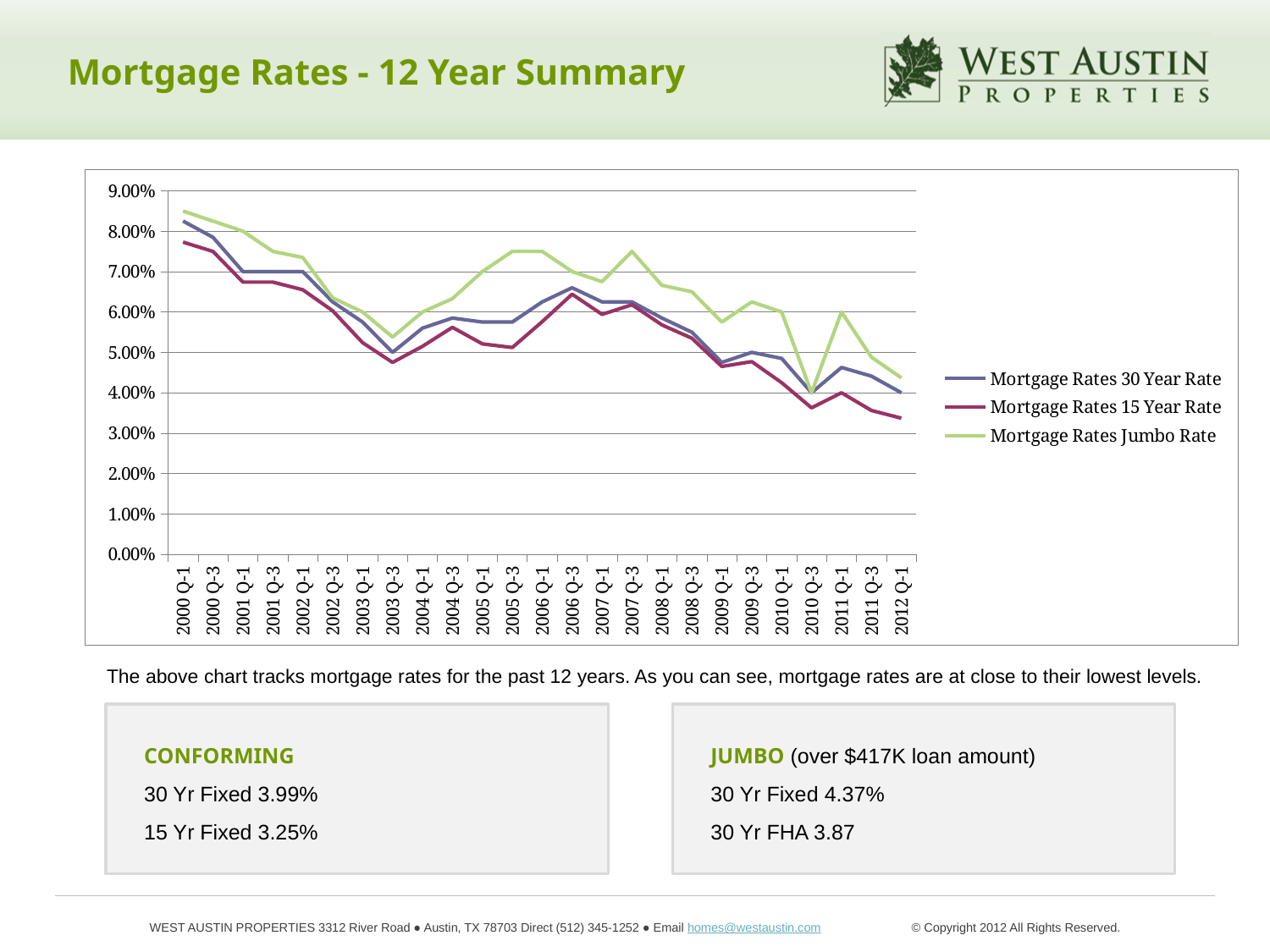
Is the Mortgage Rates 15 Year Rate at 2003 Q-3 greater or less than 5.00%? less Is the Mortgage Rates 15 Year Rate at 2012 Q-1 greater or less than 4.00%? less Is the Mortgage Rates Jumbo Rate at 2005 Q-3 greater or less than 7.00%? greater How many series does the chart legend list? 3 Overall, do the mortgage rates rise or fall from 2000 Q-1 to 2012 Q-1? fall Which series has the highest value at 2011 Q-1? Mortgage Rates Jumbo Rate At 2000 Q-1, which is larger: the Mortgage Rates Jumbo Rate or the Mortgage Rates 15 Year Rate? Mortgage Rates Jumbo Rate What is the highest value shown on the chart's vertical axis? 9.00% Which series has the lowest value at 2012 Q-1? Mortgage Rates 15 Year Rate What kind of chart is shown on the slide? line chart